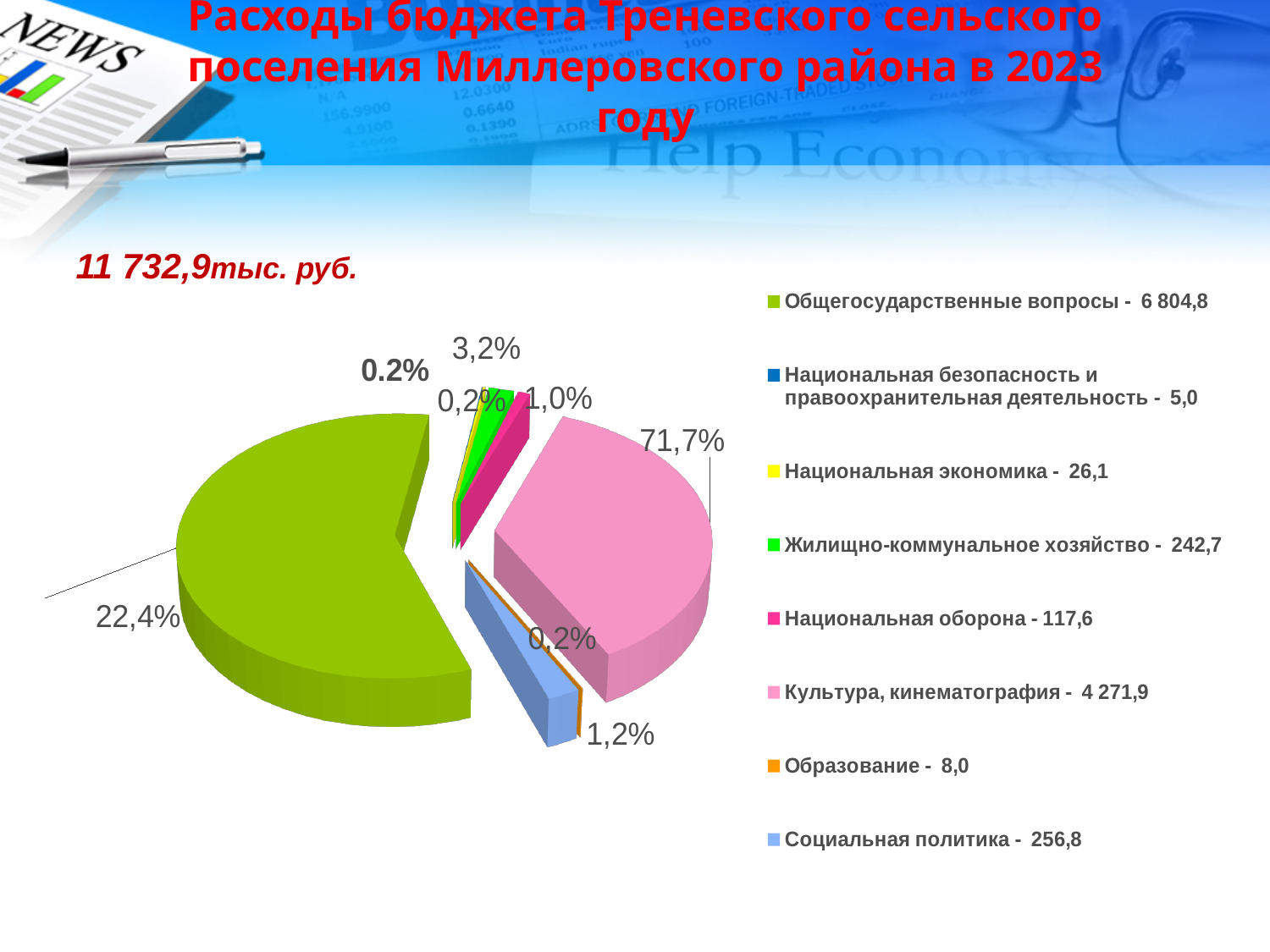
Which category has the smallest value according to the legend? Национальная безопасность и правоохранительная деятельность Which category has the largest value according to the legend? Общегосударственные вопросы By how much does the legend value for Общегосударственные вопросы exceed that for Культура, кинематография? 2 532,9 What value is given in the legend for Национальная оборона? 117,6 Which has the larger legend value: Жилищно-коммунальное хозяйство or Социальная политика? Социальная политика What total amount is printed above the chart? 11 732,9 тыс. руб. What kind of chart is shown on the slide? pie chart What value is given in the legend for Образование? 8,0 How many categories does the legend of the pie chart list? 8 What value is given in the legend for Культура, кинематография? 4 271,9 What value is given in the legend for Социальная политика? 256,8 What value is given in the legend for Общегосударственные вопросы? 6 804,8